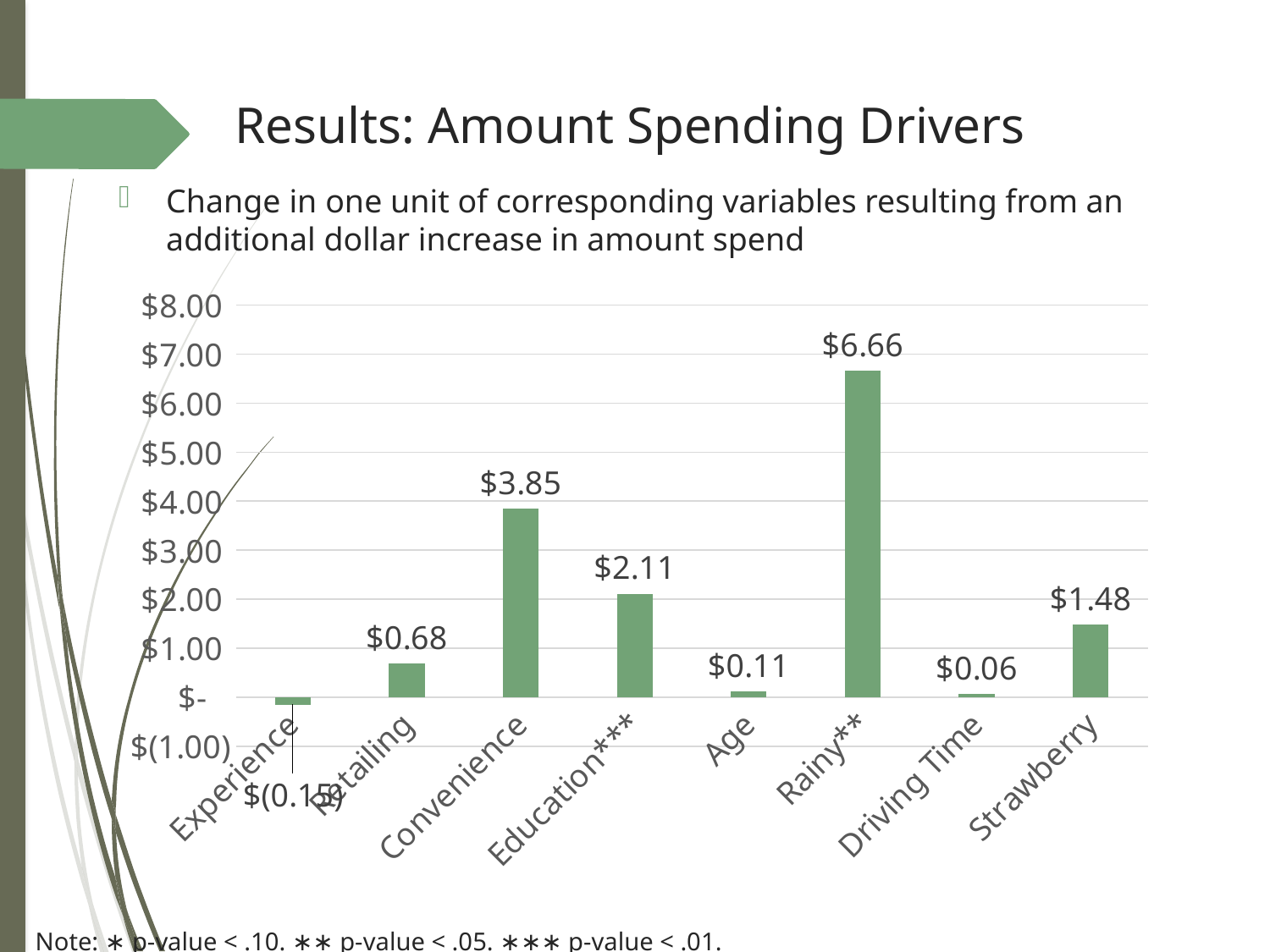
What is the difference between the values for Strawberry and Retailing? $0.80 What is the value for Driving Time in the chart? $0.06 Which category has the lowest value in the chart? Experience What is the value for Strawberry in the chart? $1.48 What is the value for Convenience in the chart? $3.85 What is the value for Education*** in the chart? $2.11 What kind of chart is shown on the slide? Bar chart How many categories are shown on the x axis of the chart? 8 Which is larger, the value for Education*** or the value for Strawberry? Education*** What is the difference between the values for Rainy** and Convenience? $2.81 What is the value for Rainy** in the chart? $6.66 Which category has the highest value in the chart? Rainy**